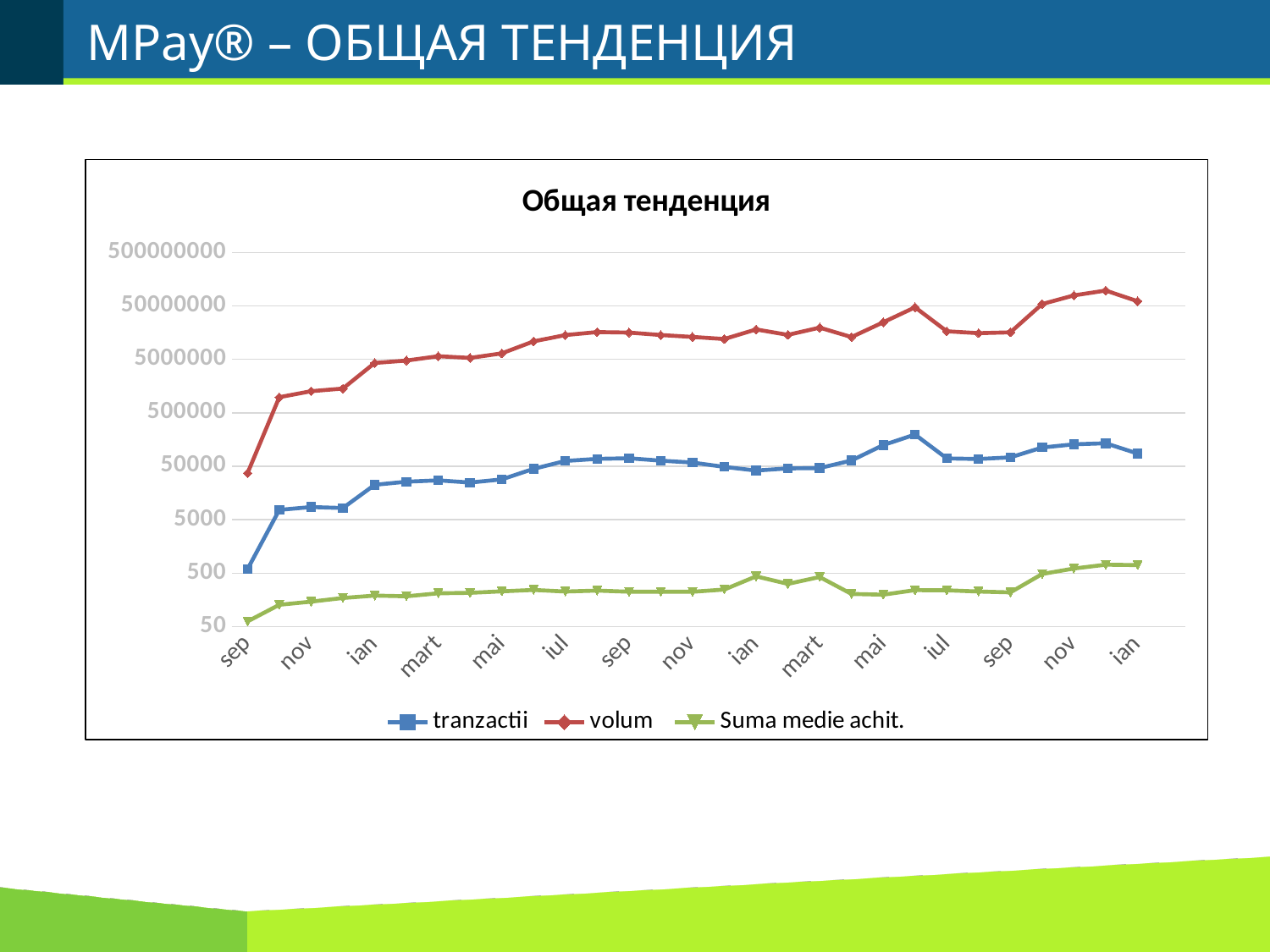
Is the value of volum at the first nov greater or less than 5000000? less Does the volum series generally rise or fall from the first sep to the final ian? rise Is the value of Suma medie achit. at the final ian greater or less than 500? greater Is the value of tranzactii at the final ian greater or less than 50000? greater Which series is drawn in red? volum Which series has the higher value at the first sep, volum or tranzactii? volum How many month labels are shown along the x axis? 15 How many series does the legend list? 3 What is the title of the chart? Общая тенденция What kind of chart is shown on the slide? line chart